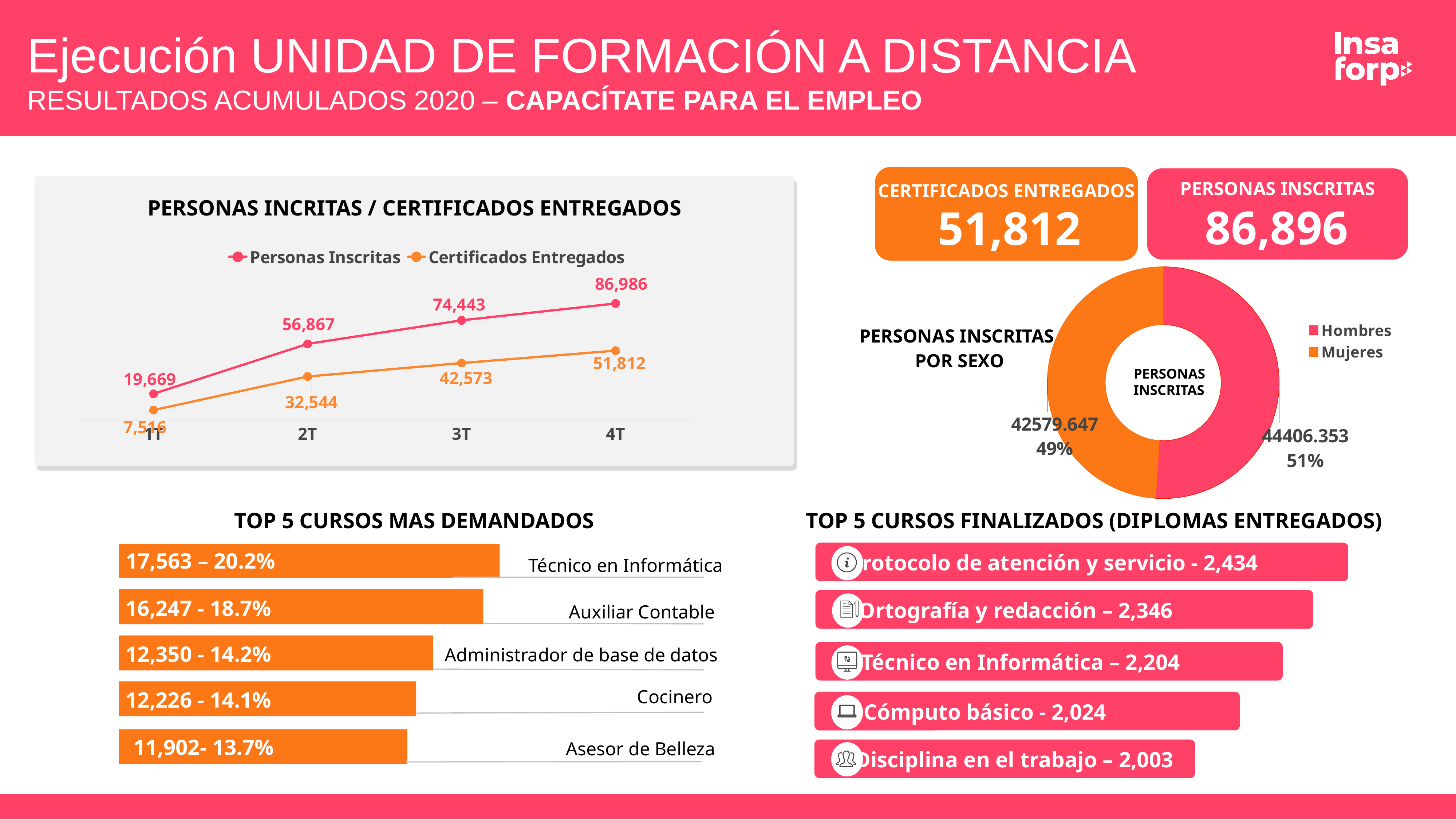
In the line chart 'PERSONAS INCRITAS / CERTIFICADOS ENTREGADOS', how many series does the legend list? 2 In the line chart 'PERSONAS INCRITAS / CERTIFICADOS ENTREGADOS', how many quarters are shown on the x axis? 4 In the donut chart 'PERSONAS INSCRITAS POR SEXO', which group has the larger share, Hombres or Mujeres? Hombres In the line chart 'PERSONAS INCRITAS / CERTIFICADOS ENTREGADOS', do the Personas Inscritas values rise or fall from 1T to 4T? rise In the line chart 'PERSONAS INCRITAS / CERTIFICADOS ENTREGADOS', what is the difference between Personas Inscritas and Certificados Entregados at 4T? 35,174 In the line chart 'PERSONAS INCRITAS / CERTIFICADOS ENTREGADOS', what is the value of Certificados Entregados at 2T? 32,544 In the chart 'TOP 5 CURSOS MAS DEMANDADOS', which course has the highest value? Técnico en Informática In the line chart 'PERSONAS INCRITAS / CERTIFICADOS ENTREGADOS', at which quarter is Certificados Entregados lowest? 1T In the line chart 'PERSONAS INCRITAS / CERTIFICADOS ENTREGADOS', what is the value of Personas Inscritas at 4T? 86,986 In the chart 'TOP 5 CURSOS MAS DEMANDADOS', what is the difference between Técnico en Informática (17,563) and Auxiliar Contable (16,247)? 1,316 In the donut chart 'PERSONAS INSCRITAS POR SEXO', what percentage share is Hombres? 51% In the chart 'TOP 5 CURSOS MAS DEMANDADOS', what kind of chart is used? bar chart